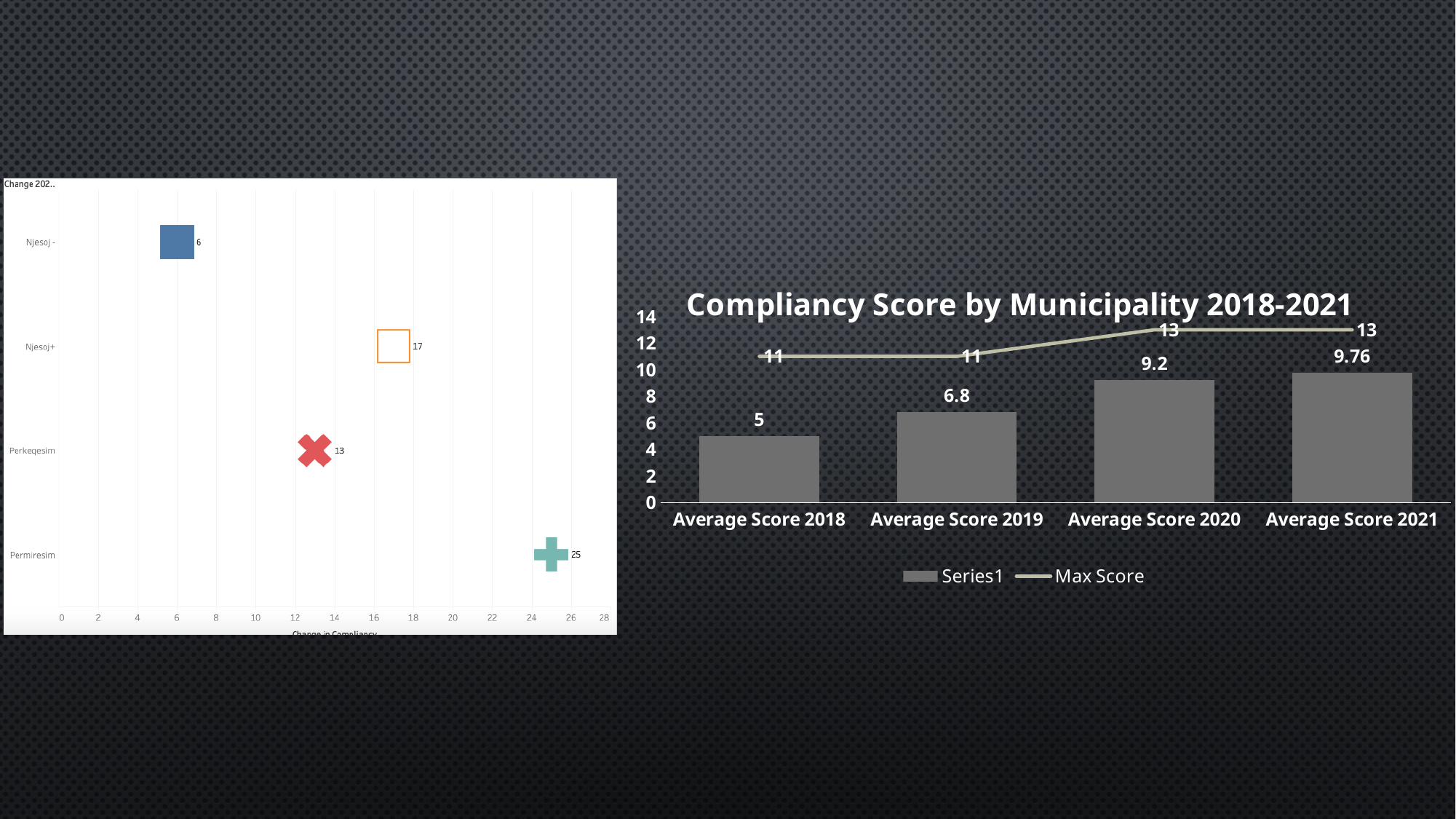
In the chart titled 'Compliancy Score by Municipality 2018-2021', which category has the lowest Series1 value? Average Score 2018 In the chart on the left side of the slide, which is larger, the value for Perkeqesim or the value for Njesoj+? Njesoj+ In the chart titled 'Compliancy Score by Municipality 2018-2021', how many series does the legend list? 2 In the chart titled 'Compliancy Score by Municipality 2018-2021', do the Series1 values rise or fall from 2018 to 2021? rise In the chart on the left side of the slide, which category has the lowest value? Njesoj - In the chart on the left side of the slide, what is the value for Permiresim? 25 In the chart titled 'Compliancy Score by Municipality 2018-2021', how many categories are shown on the x axis? 4 In the chart titled 'Compliancy Score by Municipality 2018-2021', what is the difference between the Series1 values for Average Score 2020 and Average Score 2018? 4.2 In the chart titled 'Compliancy Score by Municipality 2018-2021', which category has the highest Series1 value? Average Score 2021 In the chart titled 'Compliancy Score by Municipality 2018-2021', what is the Series1 value for Average Score 2019? 6.8 In the chart titled 'Compliancy Score by Municipality 2018-2021', what is the Max Score value for Average Score 2020? 13 In the chart on the left side of the slide, what is the value for Njesoj+? 17